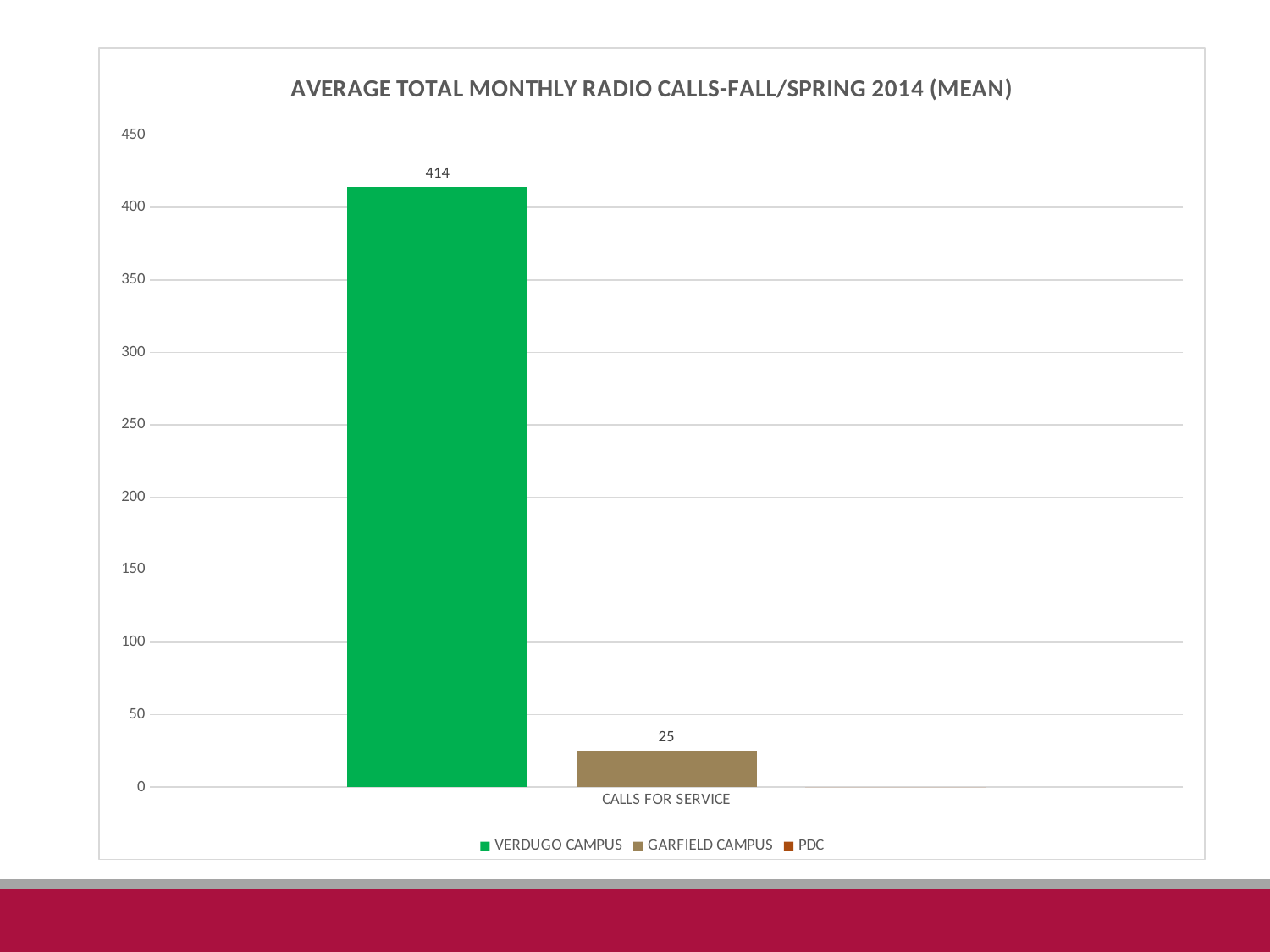
Which series has the lowest value? PDC Which is larger, the value for Verdugo Campus or the value for Garfield Campus? Verdugo Campus What is the value for Garfield Campus? 25 What kind of chart is shown? bar chart What is the difference between the Verdugo Campus and Garfield Campus values? 389 Is the value for Garfield Campus greater or less than 50? less What is the category label on the x axis? CALLS FOR SERVICE Is the value for Verdugo Campus greater or less than 400? greater Which series has the highest value? Verdugo Campus How many series does the legend list? 3 What is the title of the chart? AVERAGE TOTAL MONTHLY RADIO CALLS-FALL/SPRING 2014 (MEAN) What is the value for Verdugo Campus? 414